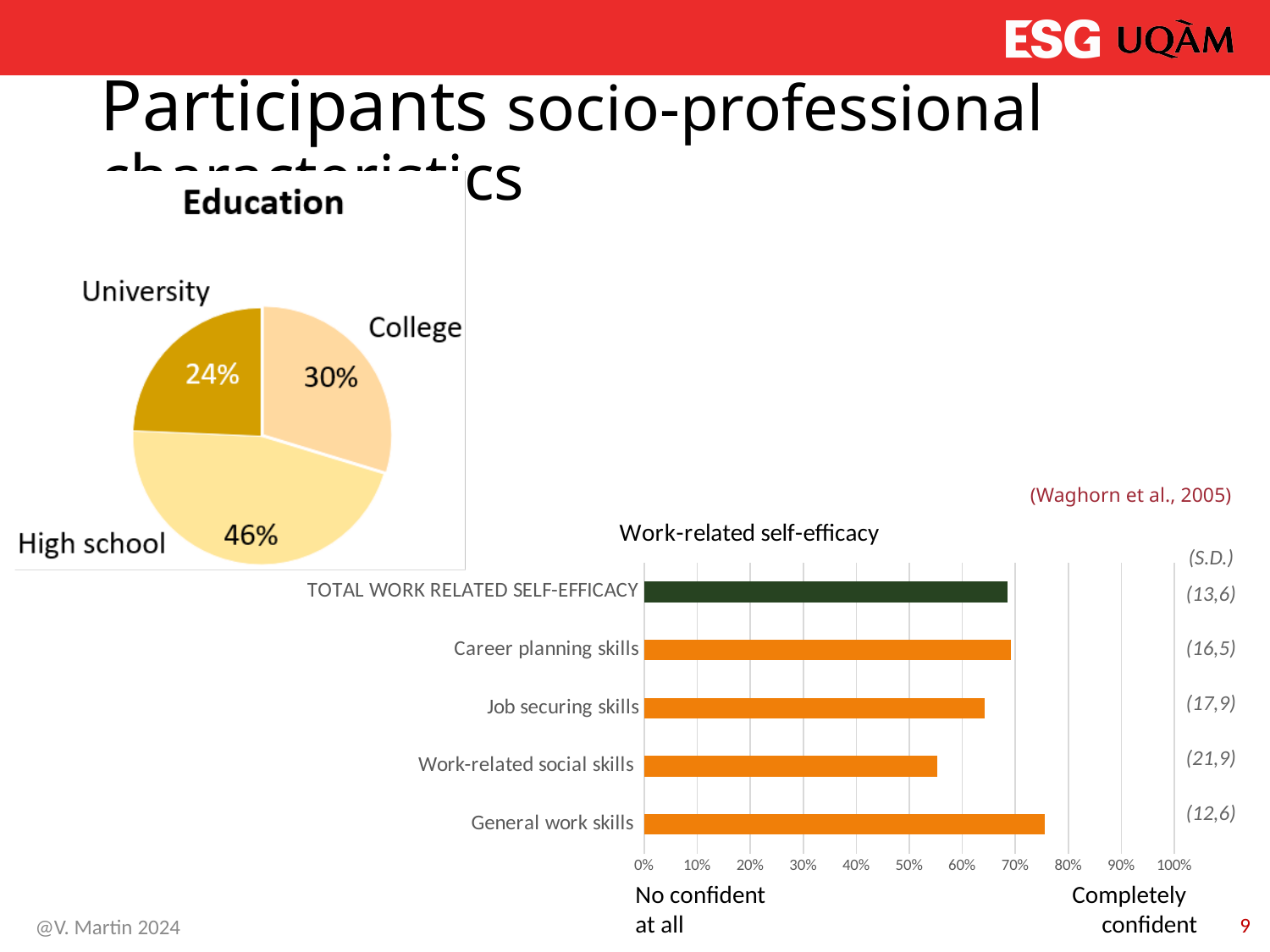
In the Work-related self-efficacy chart, which category has the lowest value? Work-related social skills In the Work-related self-efficacy chart, which is larger: Job securing skills or Work-related social skills? Job securing skills In the Education pie chart, what percentage of participants have a university education? 24% In the Education pie chart, what share of participants have a high school education? 46% How many categories are shown in the Work-related self-efficacy bar chart? 5 In the Work-related self-efficacy chart, is the value for Work-related social skills greater or less than 60%? less In the Education pie chart, which education level has the smallest share? University In the Education pie chart, which education level has the largest share? High school How many slices does the Education pie chart have? 3 In the Education pie chart, what is the difference in percentage points between the High school and College shares? 16 In the Work-related self-efficacy chart, which category has the highest value? General work skills What kind of chart is the Work-related self-efficacy chart? Bar chart